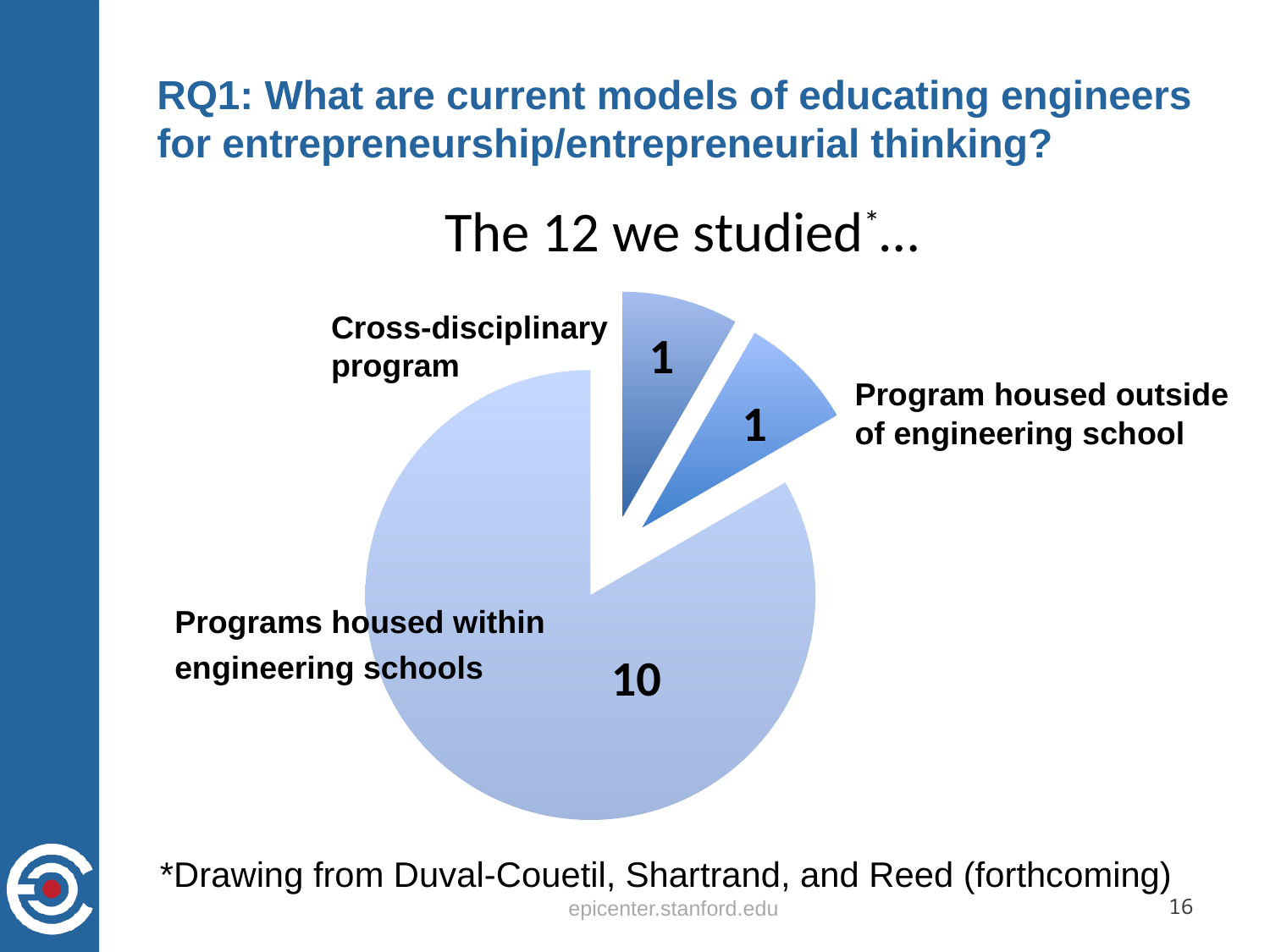
What share of the pie does Programs housed within engineering schools represent? 10 of 12 What is the value for Programs housed within engineering schools? 10 Which is larger: the value for Programs housed within engineering schools or the value for Program housed outside of engineering school? Programs housed within engineering schools What is the difference between the value for Programs housed within engineering schools and the value for Cross-disciplinary program? 9 Which slice of the pie is the darkest blue? Cross-disciplinary program What kind of chart is shown on the slide? pie chart What is the title shown above the pie chart? The 12 we studied*... Which category has the largest slice of the pie? Programs housed within engineering schools What is the total of all the slices in the pie chart? 12 What is the value for Cross-disciplinary program? 1 What is the value for Program housed outside of engineering school? 1 How many slices does the pie chart have? 3